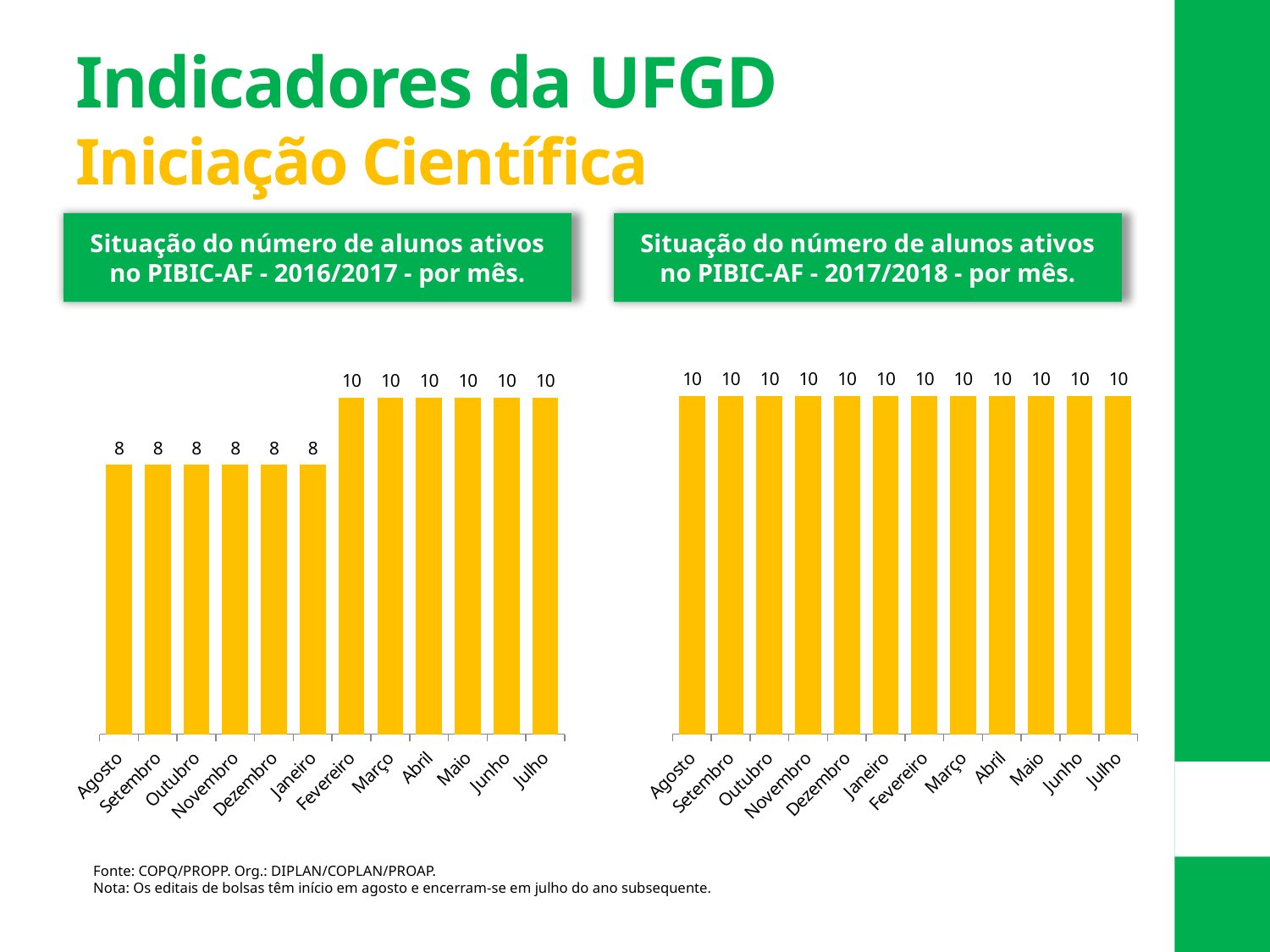
In the 2016/2017 chart (left), do the values rise or fall from Agosto to Julho? rise In the 2016/2017 chart (left), what is the lowest value shown? 8 What colour are the bars in both charts? yellow In the 2016/2017 chart (left), what is the value for Agosto? 8 In the 2016/2017 chart (left), what is the difference between the values for Março and Janeiro? 2 In the 2017/2018 chart (right), what is the highest value shown? 10 In the 2016/2017 chart (left), which is larger, the value for Novembro or the value for Abril? Abril How many bars are in the 2016/2017 chart (left)? 12 In the 2016/2017 chart (left), what is the value for Fevereiro? 10 In the 2017/2018 chart (right), what is the value for Dezembro? 10 How many months are shown on the x axis of the 2017/2018 chart (right)? 12 What kind of chart is the 2017/2018 chart (right)? bar chart